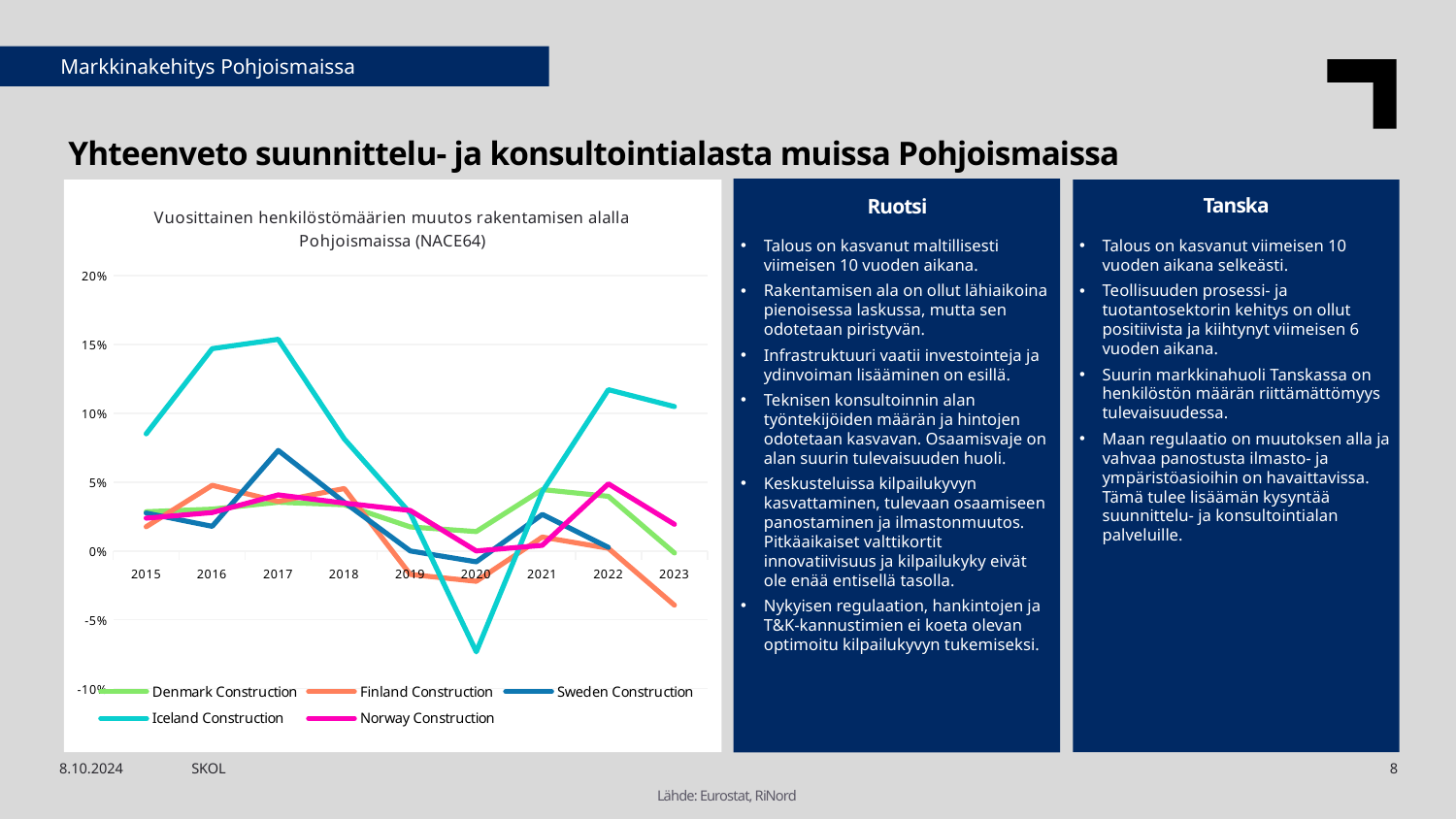
How many series does the chart legend list? 5 How many years are plotted along the x axis of the chart? 9 In 2017, which is larger: Sweden Construction or Finland Construction? Sweden Construction What is the last year shown on the x axis of the chart? 2023 What kind of chart is shown on the slide? line chart Does the Iceland Construction line rise or fall from 2017 to 2020? fall Which series reaches the lowest value on the chart? Iceland Construction Is the value for Iceland Construction in 2020 greater or less than -5%? less What is the title of the chart? Vuosittainen henkilöstömäärien muutos rakentamisen alalla Pohjoismaissa (NACE64) Is the value for Iceland Construction in 2017 greater or less than 10%? greater Which series reaches the highest value on the chart? Iceland Construction What is the first year shown on the x axis of the chart? 2015